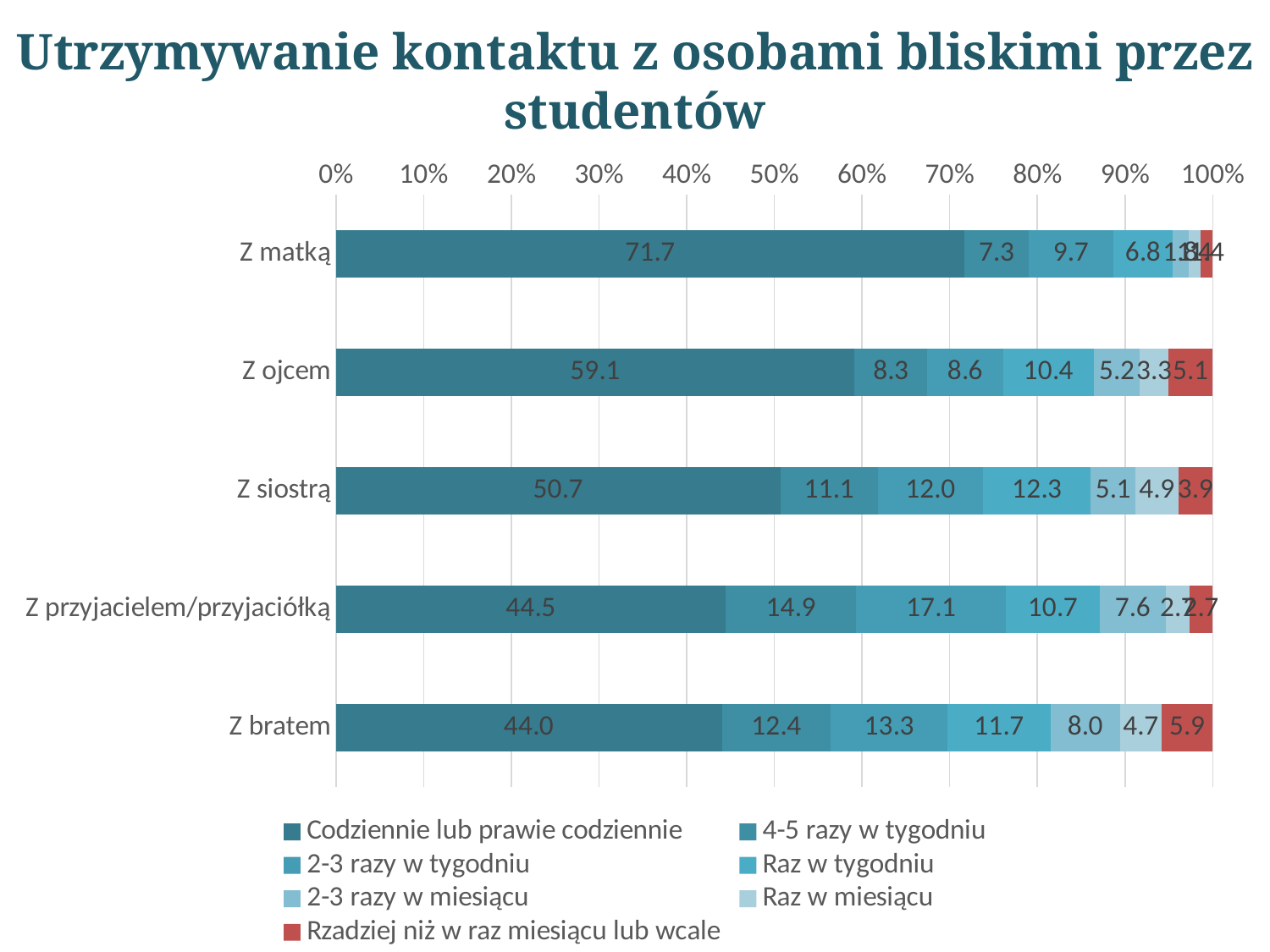
Which category has the highest value for "Codziennie lub prawie codziennie"? Z matką What kind of chart is shown on the slide? Stacked bar chart Which category has the lowest value for "Codziennie lub prawie codziennie"? Z bratem What is the value for "2-3 razy w tygodniu" for "Z przyjacielem/przyjaciółką"? 17.1 Which has the larger "Raz w tygodniu" value, "Z siostrą" or "Z bratem"? Z siostrą What is the value for "Raz w tygodniu" for "Z ojcem"? 10.4 How many series does the legend list? 7 Is the "Codziennie lub prawie codziennie" value for "Z bratem" greater or less than 50%? less How many categories are shown on the chart? 5 What is the value for "Rzadziej niż w raz miesiącu lub wcale" for "Z bratem"? 5.9 What is the value for "Codziennie lub prawie codziennie" for "Z matką"? 71.7 What is the difference between the "Codziennie lub prawie codziennie" values for "Z ojcem" and "Z siostrą"? 8.4